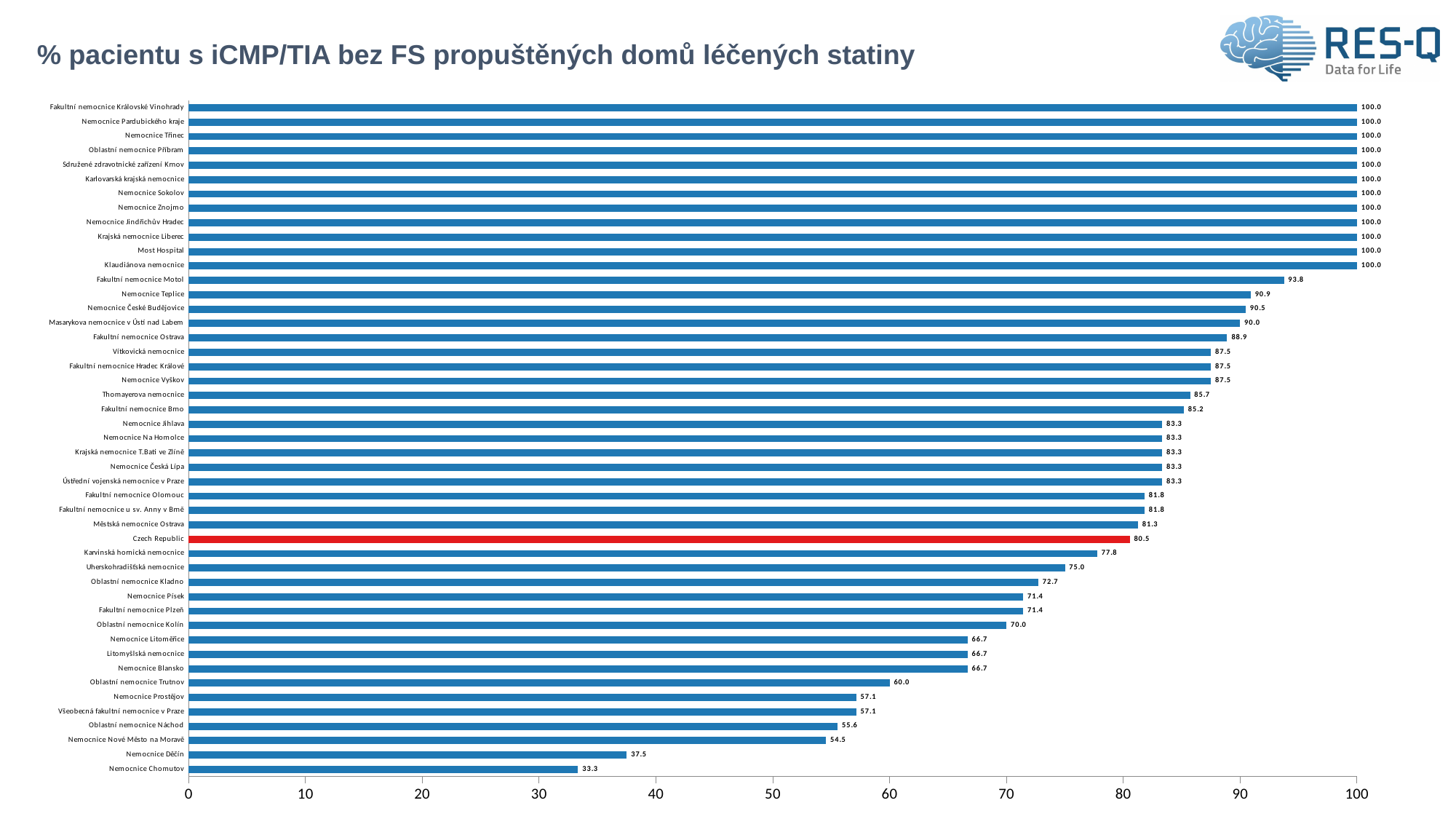
What is the value for Oblastní nemocnice Kladno? 72.7 Which is larger, the value for Nemocnice Teplice or the value for Fakultní nemocnice Ostrava? Nemocnice Teplice What is the value for Nemocnice Chomutov? 33.3 What is the difference between the values for Fakultní nemocnice Motol and Czech Republic? 13.3 Which bar is coloured red instead of blue? Czech Republic What is the value for Fakultní nemocnice Motol? 93.8 What is the value for Czech Republic? 80.5 What is the difference between the values for Nemocnice Děčín and Nemocnice Chomutov? 4.2 What kind of chart is shown on the slide? bar chart How many bars are shown in the chart? 47 Which hospital has the lowest value? Nemocnice Chomutov Is the value for Oblastní nemocnice Trutnov greater or less than 70? less